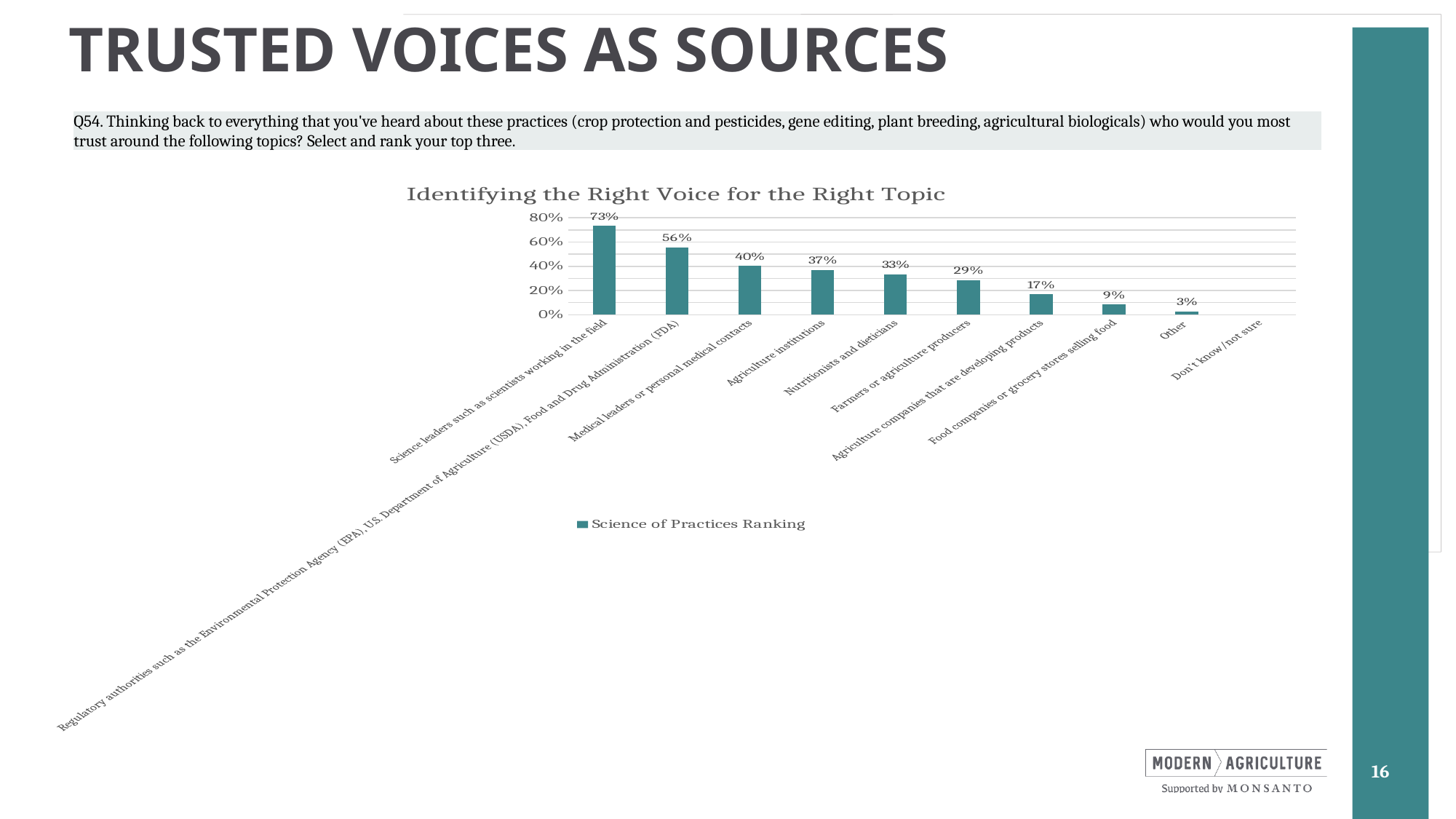
What is the value for Food companies or grocery stores selling food? 9% What is the value for Farmers or agriculture producers? 29% Which category has the highest value? Science leaders such as scientists working in the field What is the difference between the values for Science leaders such as scientists working in the field and Regulatory authorities such as the EPA, USDA, FDA? 17% Is the value for Agriculture companies that are developing products greater or less than 20%? less How many categories are listed on the x axis? 10 What is the value for Medical leaders or personal medical contacts? 40% What kind of chart is shown on the slide? bar chart How many series does the legend list? 1 Which is larger, the value for Agriculture institutions or the value for Nutritionists and dieticians? Agriculture institutions What is the value for Science leaders such as scientists working in the field? 73% What is the title of the chart? Identifying the Right Voice for the Right Topic